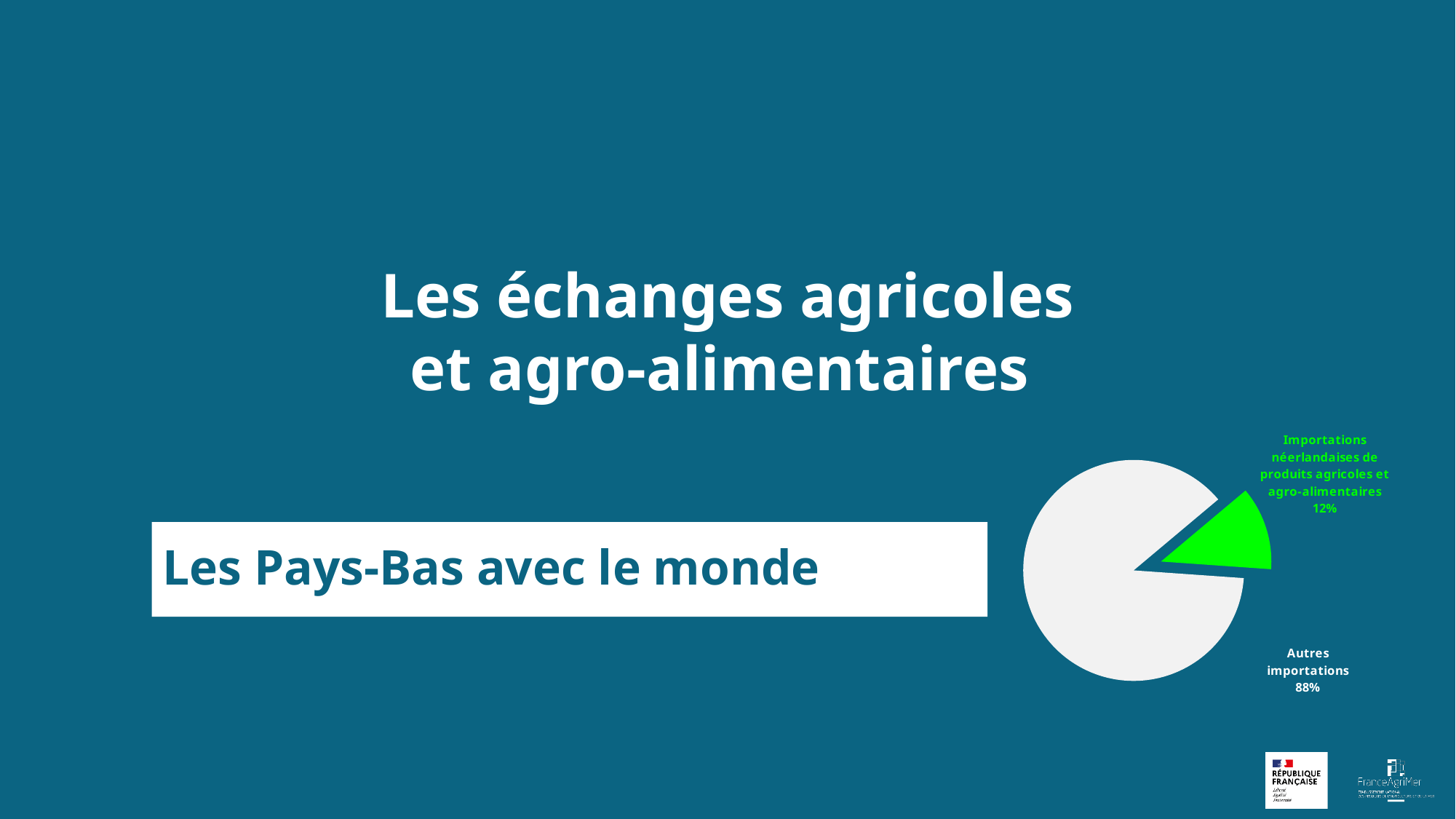
What kind of chart is shown on the slide? Pie chart Which slice of the pie chart is the largest? Autres importations What share of the pie is labelled "Autres importations"? 88% What is the total of the two percentages shown on the pie chart? 100% Which is larger: the "Autres importations" slice or the "Importations néerlandaises de produits agricoles et agro-alimentaires" slice? Autres importations How many slices does the pie chart have? 2 What colour is the "Autres importations" slice? White What is the difference in percentage points between the "Autres importations" slice and the "Importations néerlandaises de produits agricoles et agro-alimentaires" slice? 76 percentage points What share of the pie is labelled "Importations néerlandaises de produits agricoles et agro-alimentaires"? 12% Which slice of the pie chart is the smallest? Importations néerlandaises de produits agricoles et agro-alimentaires What colour is the "Importations néerlandaises de produits agricoles et agro-alimentaires" slice? Green